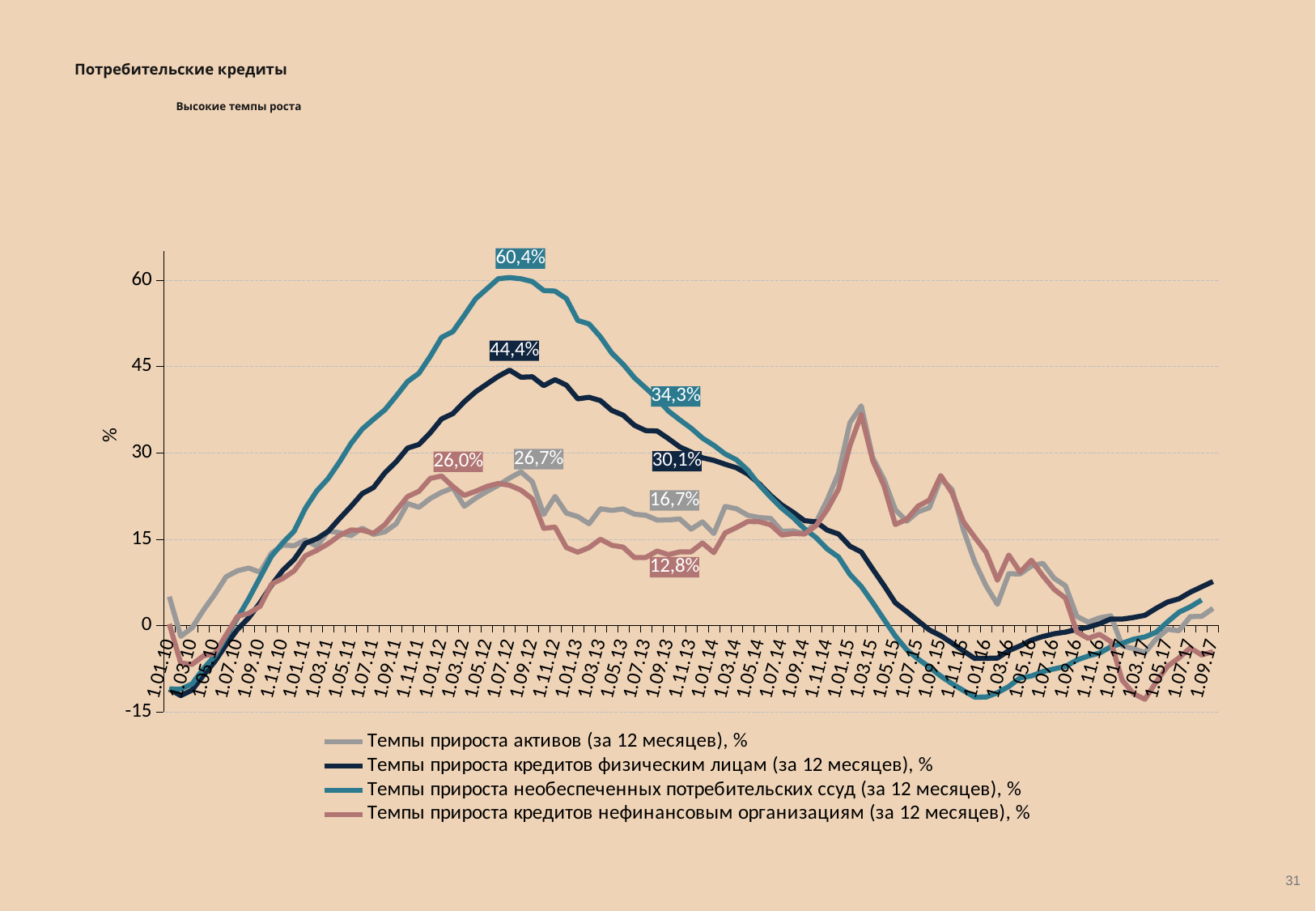
What is the peak value labelled for the series 'Темпы прироста кредитов физическим лицам (за 12 месяцев), %'? 44,4% What value is labelled for the series 'Темпы прироста активов (за 12 месяцев), %' near 1.09.13? 16,7% What is the peak value labelled for the series 'Темпы прироста необеспеченных потребительских ссуд (за 12 месяцев), %'? 60,4% Near 1.09.13, which is larger: the labelled value for unsecured consumer loans (34,3%) or for loans to individuals (30,1%)? unsecured consumer loans (34,3%) Is the value of the series 'Темпы прироста необеспеченных потребительских ссуд (за 12 месяцев), %' at 1.01.16 greater or less than 0? less What value is labelled for the series 'Темпы прироста кредитов нефинансовым организациям (за 12 месяцев), %' near 1.09.13? 12,8% Which series reaches the highest labelled value on the chart? Темпы прироста необеспеченных потребительских ссуд (за 12 месяцев), % What is the difference between the labelled peaks 60,4% and 44,4%? 16,0 percentage points How many series does the legend list? 4 What kind of chart is shown on the slide? line chart Does the series 'Темпы прироста необеспеченных потребительских ссуд (за 12 месяцев), %' rise or fall between 1.07.12 and 1.01.16? fall What is the difference between the labels 34,3% and 30,1% shown near 1.09.13? 4,2 percentage points